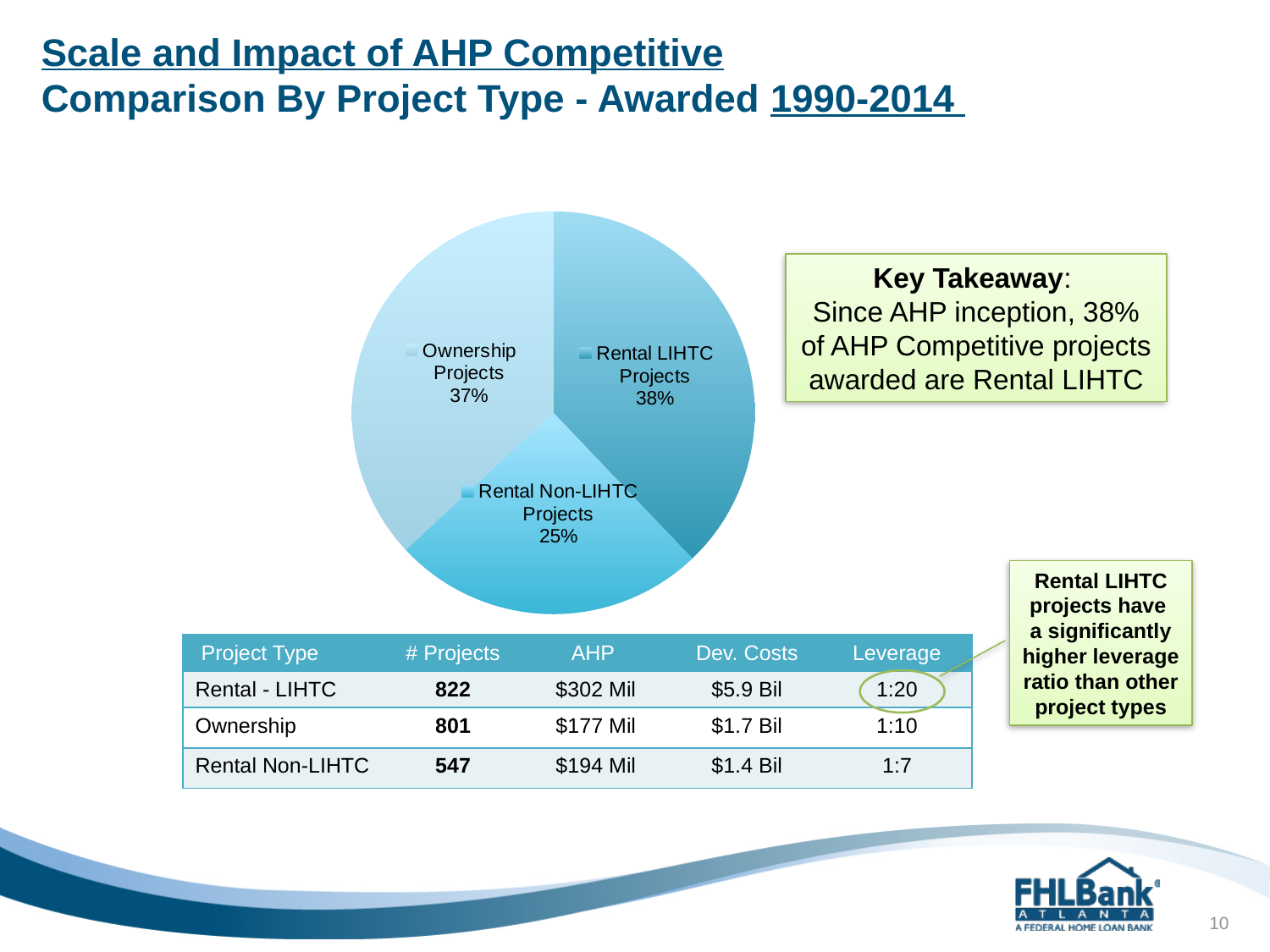
What is the difference in percentage points between the Ownership Projects slice and the Rental Non-LIHTC Projects slice? 12 What kind of chart is shown on the slide? pie chart What share of the pie is Rental LIHTC Projects? 38% What is the combined share of the Rental LIHTC Projects and Ownership Projects slices? 75% How many slices does the pie chart have? 3 Which slice is larger, Ownership Projects or Rental Non-LIHTC Projects? Ownership Projects Is the share for Rental Non-LIHTC Projects greater or less than 30%? less Which slice of the pie chart is the largest? Rental LIHTC Projects What share of the pie is Ownership Projects? 37% Which slice of the pie chart is the smallest? Rental Non-LIHTC Projects What share of the pie is Rental Non-LIHTC Projects? 25% What is the difference in percentage points between the Rental LIHTC Projects slice and the Rental Non-LIHTC Projects slice? 13